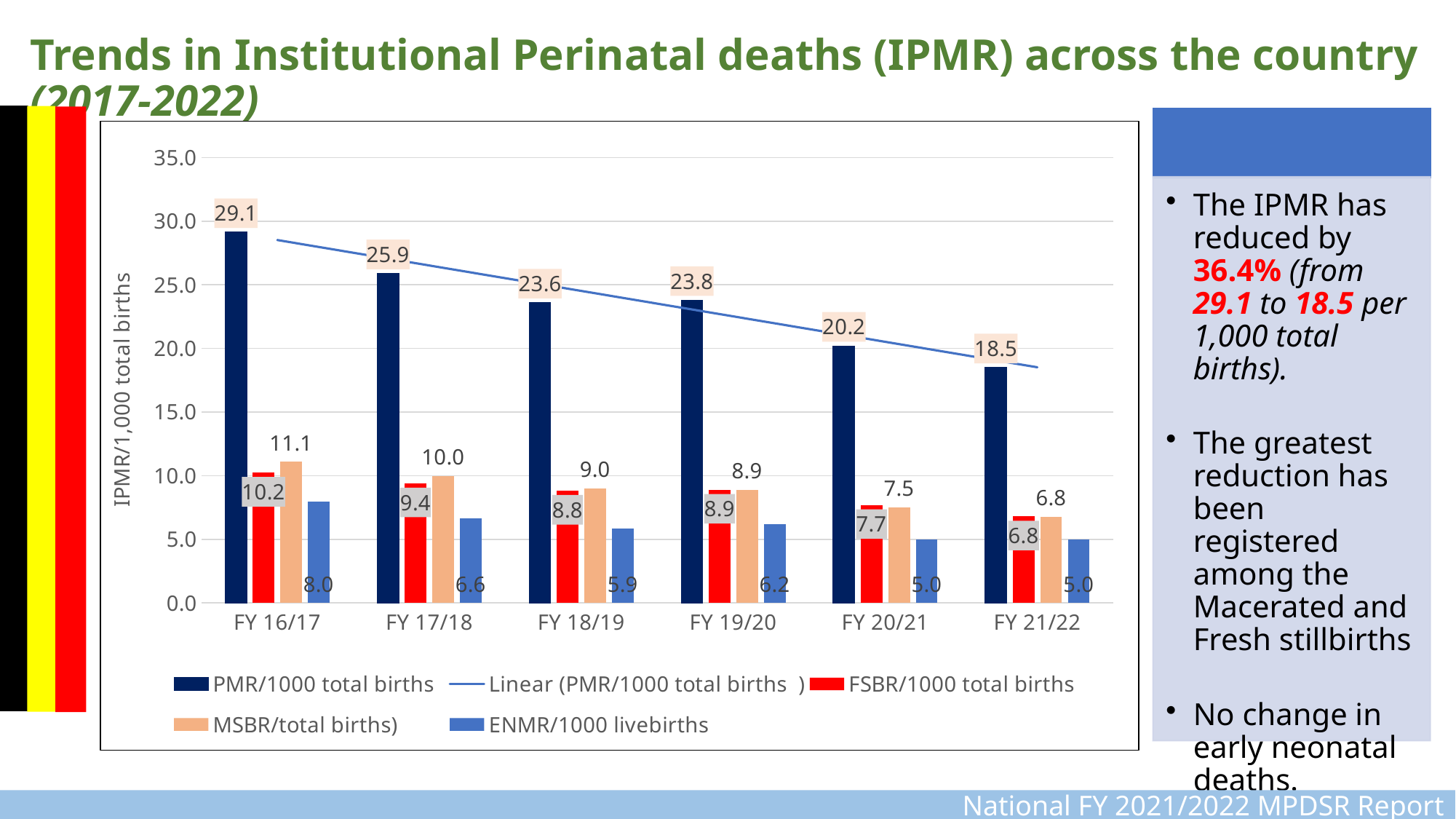
Does the PMR/1000 total births rise or fall from FY 16/17 to FY 21/22? fall Which fiscal year has the lowest PMR/1000 total births? FY 21/22 What is the ENMR/1000 livebirths value for FY 16/17? 8.0 What is the difference between the PMR/1000 total births in FY 16/17 and FY 21/22? 10.6 How many fiscal years are shown on the x axis? 6 Which is larger in FY 16/17: MSBR/total births or FSBR/1000 total births? MSBR/total births What is the PMR/1000 total births value for FY 16/17? 29.1 What kind of chart is shown on the slide? bar chart What is the PMR/1000 total births value for FY 21/22? 18.5 Which fiscal year has the highest PMR/1000 total births? FY 16/17 What is the title of the vertical axis? IPMR/1,000 total births How many entries does the legend list? 5